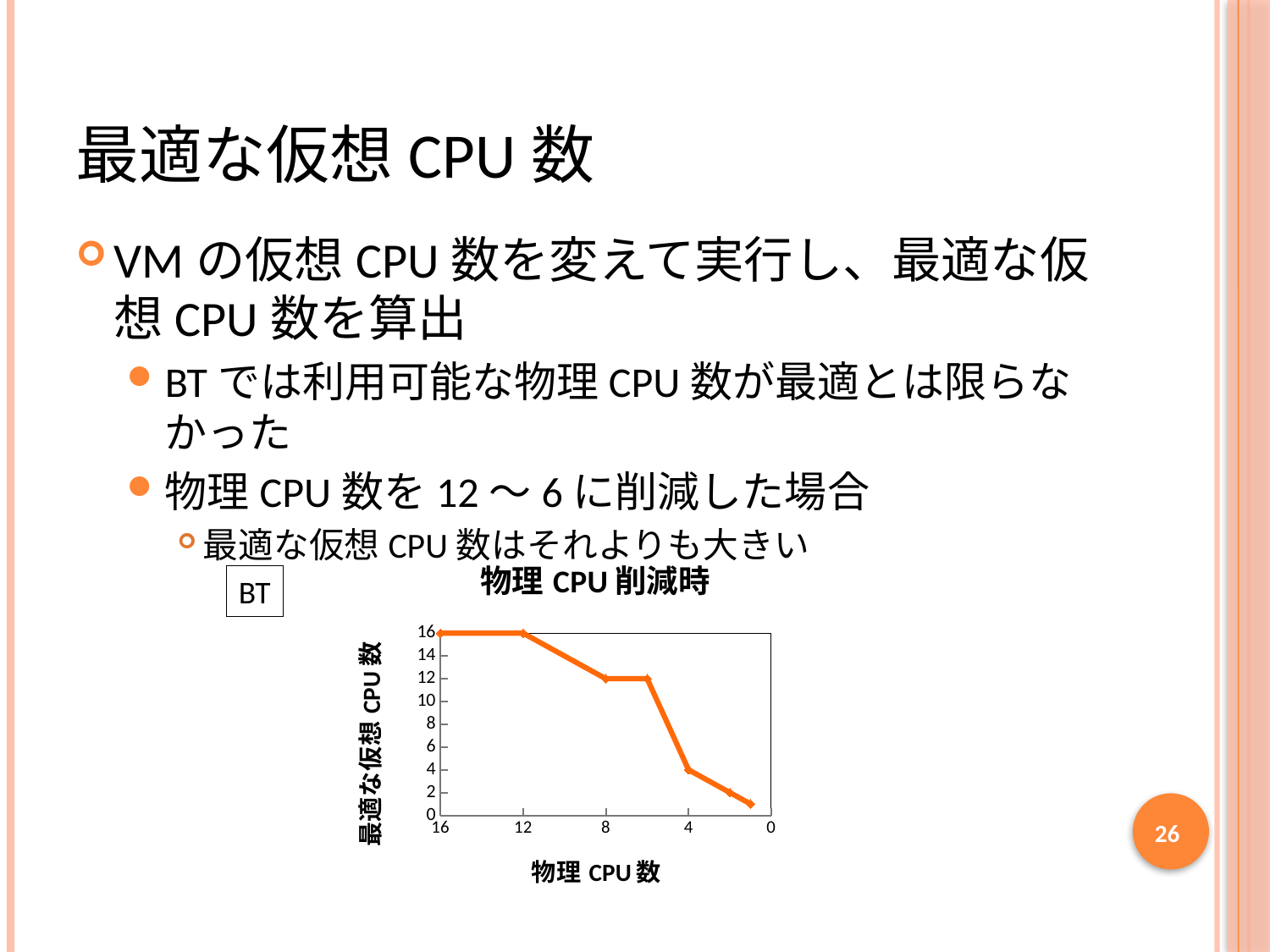
What is the label of the x axis of the chart? 物理 CPU 数 What is the optimal number of virtual CPUs (最適な仮想 CPU 数) when the number of physical CPUs is 16? 16 How many data points are plotted on the line? 7 What is the optimal number of virtual CPUs when the number of physical CPUs is 4? 4 What is the optimal number of virtual CPUs when the number of physical CPUs is 8? 12 Which has the larger optimal virtual CPU count: 8 physical CPUs or 4 physical CPUs? 8 physical CPUs What is the difference between the optimal virtual CPU count at 12 physical CPUs and at 8 physical CPUs? 4 Moving from left to right along the x axis (from 16 physical CPUs toward 0), do the plotted values rise or fall? fall What is the optimal number of virtual CPUs when the number of physical CPUs is 12? 16 What is the title of the chart? 物理 CPU 削減時 What kind of chart is shown on the slide? line chart What is the highest optimal virtual CPU count plotted on the chart? 16